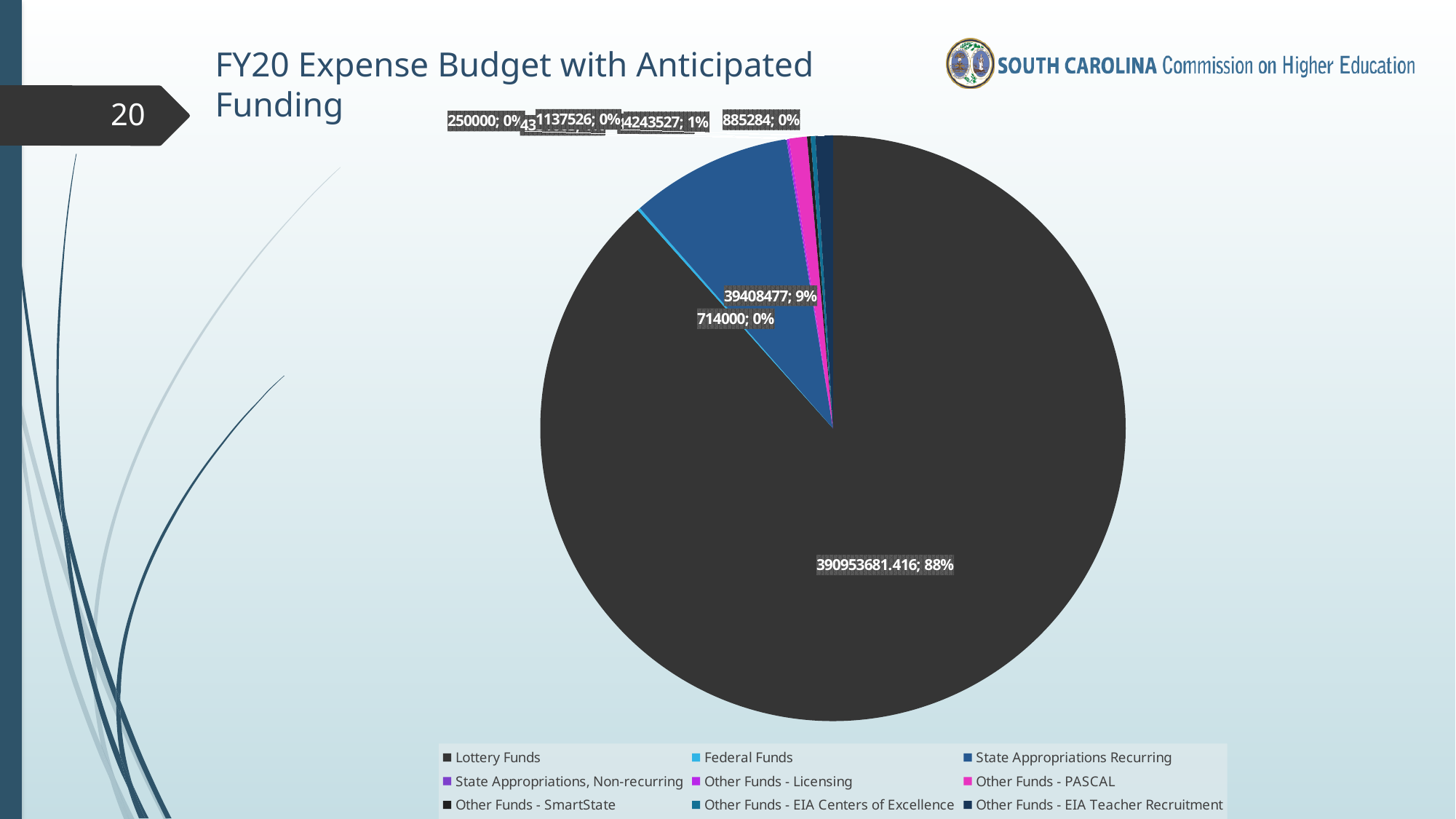
What is the value shown for Federal Funds? 714000 What share of the pie does State Appropriations Recurring account for? 9% What is the title of the chart on the slide? FY20 Expense Budget with Anticipated Funding Which category has the largest slice of the pie? Lottery Funds Which is larger, the value for Lottery Funds or the value for State Appropriations Recurring? Lottery Funds What share of the pie does Lottery Funds account for? 88% What is the value shown for State Appropriations Recurring? 39408477 What is the difference between the value for Lottery Funds and the value for State Appropriations Recurring? 351545204.416 What is the value shown for Lottery Funds? 390953681.416 What kind of chart is shown on the slide? Pie chart How many categories does the legend of the pie chart list? 9